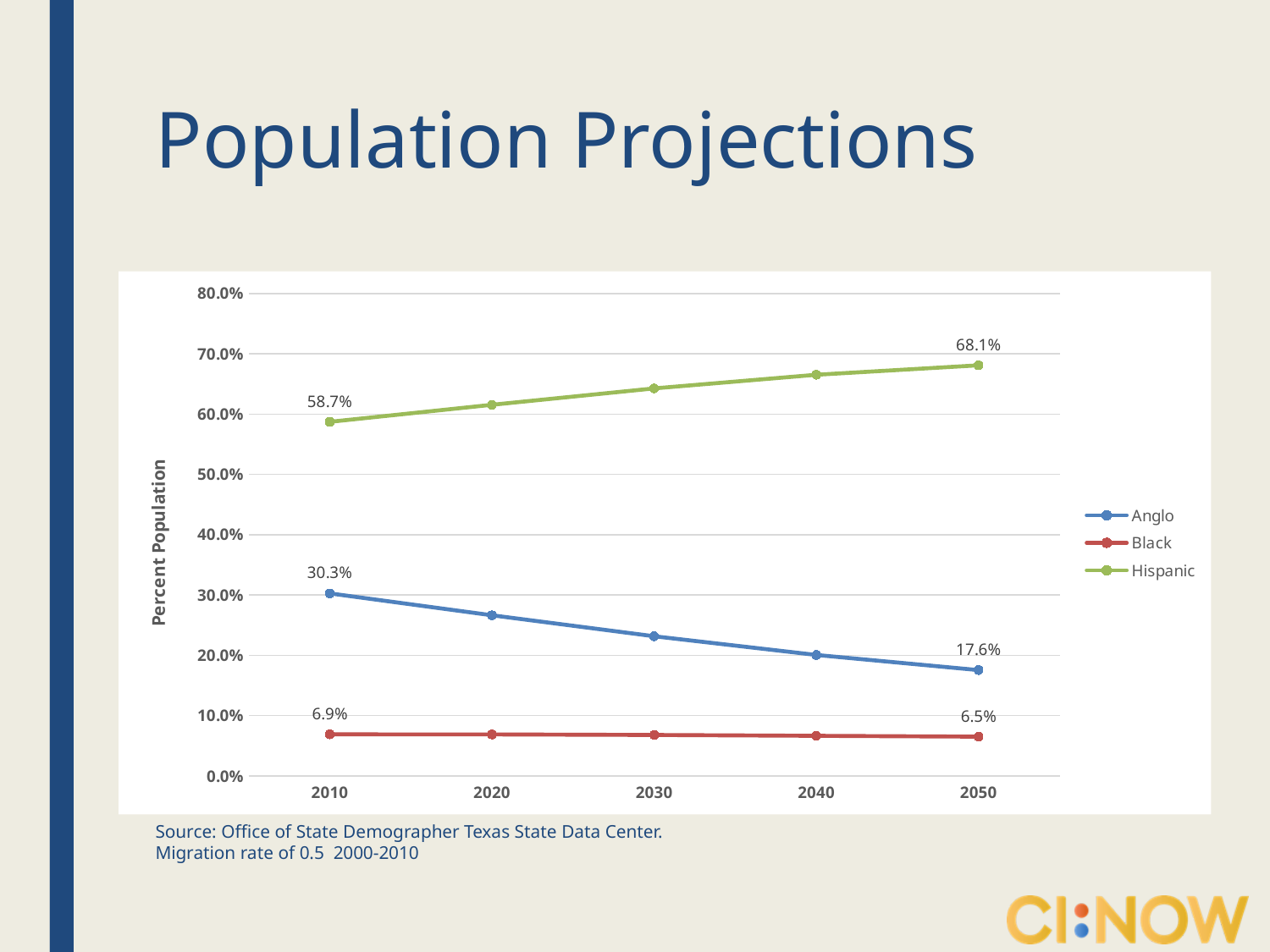
What is the Hispanic value for 2050? 68.1% Is the Anglo value for 2030 greater or less than 20.0%? greater What is the Black value for 2050? 6.5% What is the Anglo value for 2010? 30.3% Which series has the highest value in 2050? Hispanic What is the Anglo value for 2050? 17.6% Which series has the lowest value in 2010? Black What is the Hispanic value for 2010? 58.7% By how many percentage points does the Hispanic value rise from 2010 to 2050? 9.4 percentage points Does the Anglo series rise or fall from 2010 to 2050? fall How many series does the legend list? 3 By how many percentage points does the Anglo value fall from 2010 to 2050? 12.7 percentage points